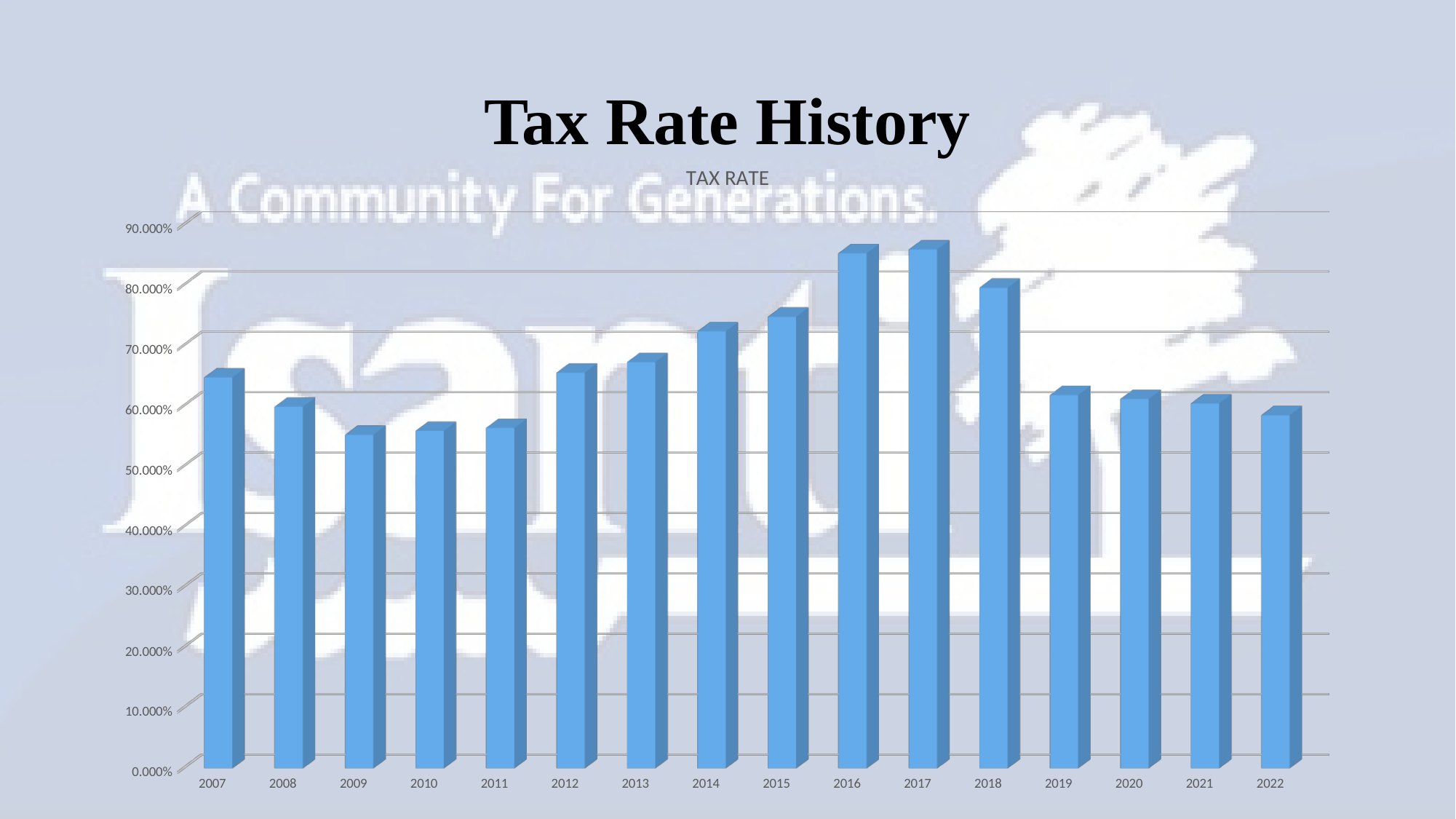
Is the tax rate for 2014 greater or less than 70.000%? greater Do the tax rates rise or fall from 2011 to 2016? rise Do the tax rates rise or fall from 2017 to 2022? fall How many years are plotted on the x axis of the chart? 16 What is the title printed above the chart's plot area? TAX RATE Which year has the higher tax rate, 2017 or 2022? 2017 Is the tax rate for 2016 greater or less than 80.000%? greater What kind of chart is shown on the slide? bar chart Which year has the higher tax rate, 2008 or 2014? 2014 Is the tax rate for 2018 greater or less than 70.000%? greater